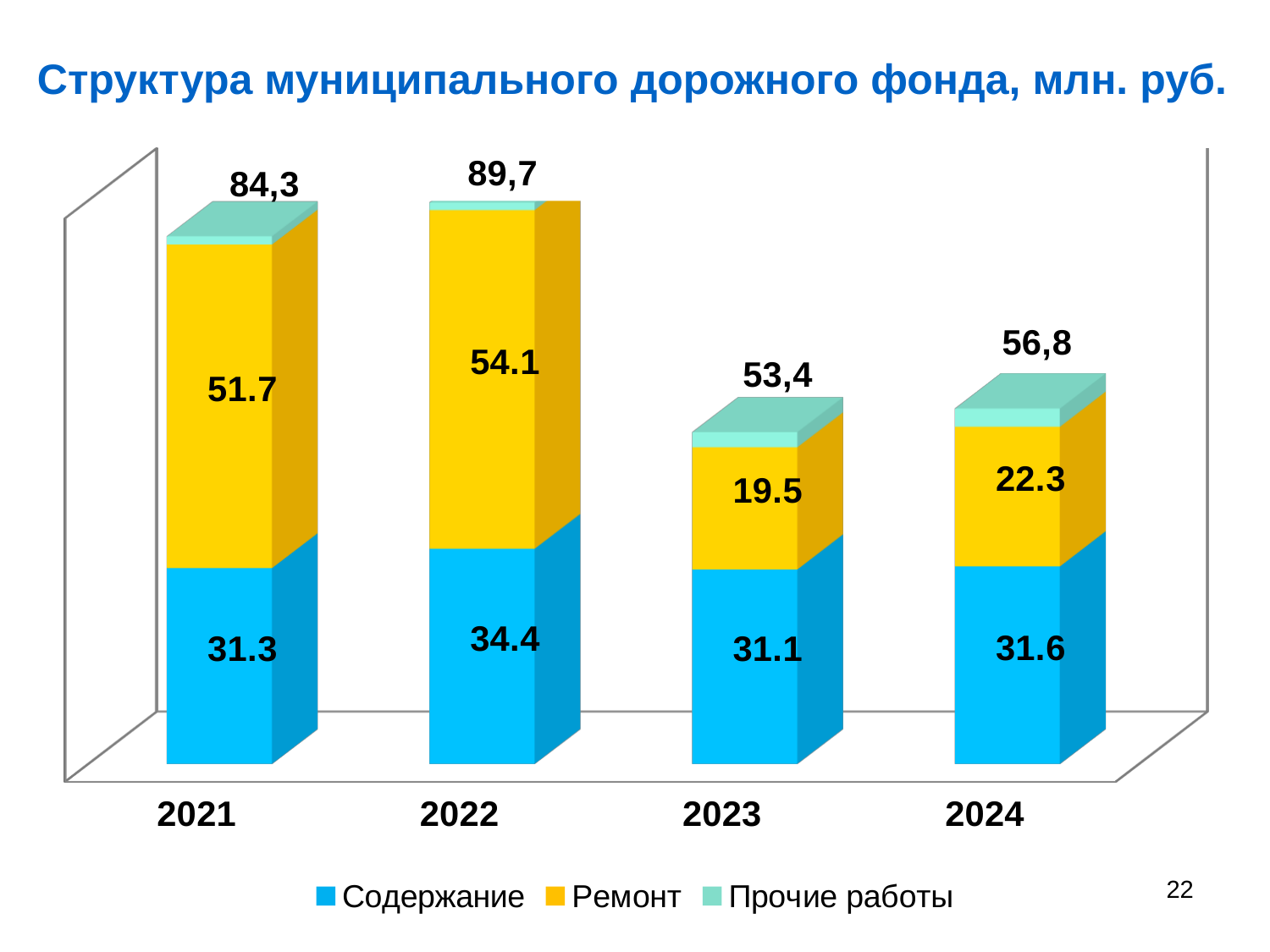
How many series does the legend list? 3 Which year has the highest total municipal road fund? 2022 What is the total of the stacked bar for 2024? 56,8 How many years are shown on the x axis? 4 What is the title of the chart? Структура муниципального дорожного фонда, млн. руб. What is the difference between the totals for 2022 and 2021? 5,4 What kind of chart is shown on the slide? stacked bar chart Which is larger, the Ремонт value in 2023 or in 2024? 2024 What is the value for Ремонт in 2022? 54.1 Which year has the lowest total municipal road fund? 2023 What is the value for Содержание in 2023? 31.1 What is the difference between the Ремонт values for 2022 and 2021? 2.4